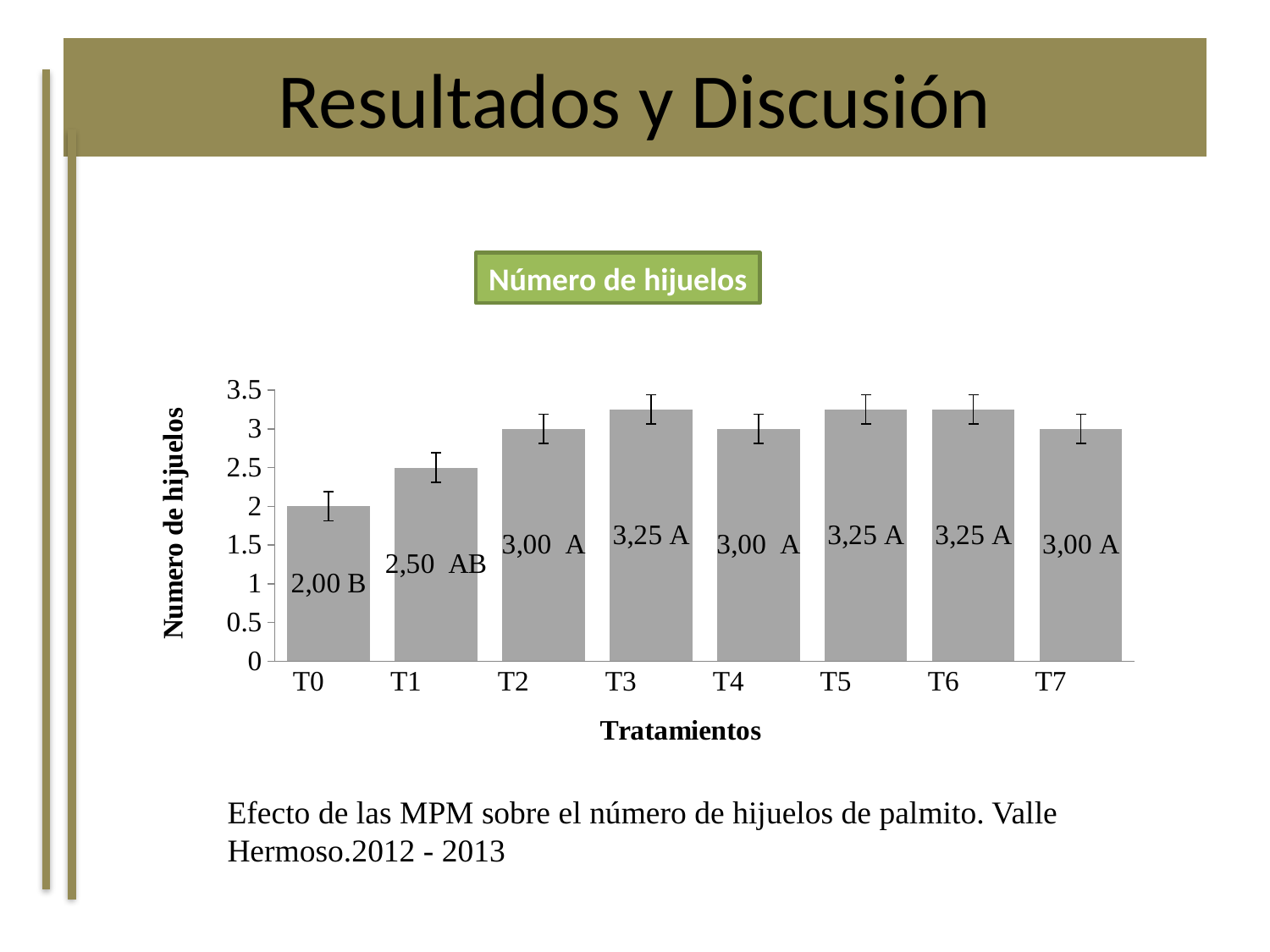
What is the difference between the values for T2 and T1? 0,50 How many treatments are shown on the x axis? 8 Which treatment has the lowest number of hijuelos? T0 What kind of chart is shown? bar chart What is the value for T1? 2,50 What is the title of the chart? Número de hijuelos Is the value for T0 greater or less than 2.5? less What is the difference between the values for T3 and T0? 1,25 Which is larger, the value for T1 or the value for T4? T4 What is the value for T3? 3,25 What is the value for T0? 2,00 What is the value for T7? 3,00